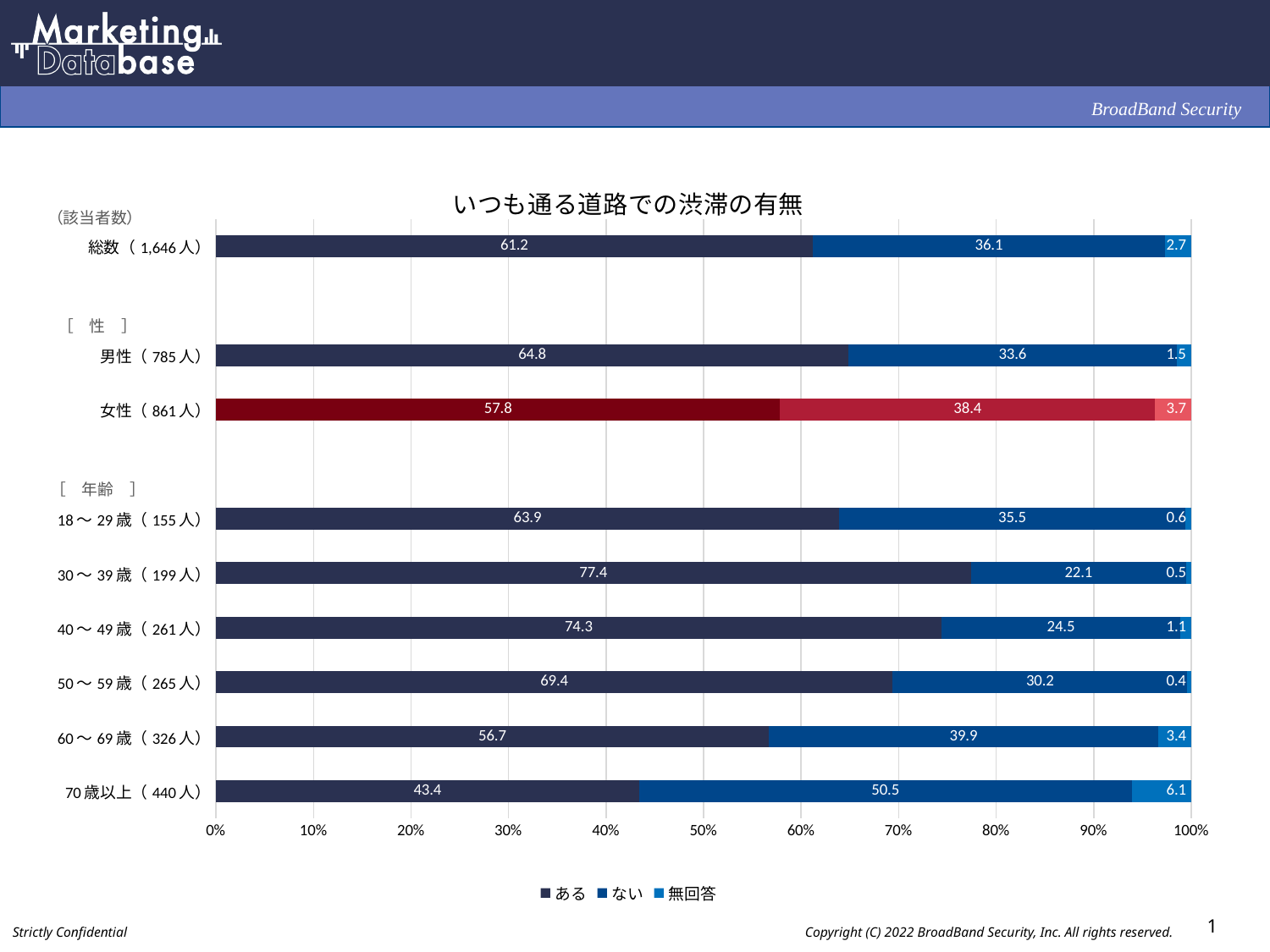
What is the value of ない for 70歳以上 (440人)? 50.5 Is the ある value for 40～49歳 (261人) greater or less than 70%? greater What is the difference between the ある values for 男性 (785人) and 女性 (861人)? 7.0 Which is larger, the ない value for 60～69歳 (326人) or for 50～59歳 (265人)? 60～69歳 (326人) Which category has the highest value for 無回答? 70歳以上 (440人) What kind of chart is shown on the slide? Stacked bar chart Which category has the lowest value for ある? 70歳以上 (440人) What is the value of ある for 総数 (1,646人)? 61.2 Which category has the highest value for ある? 30～39歳 (199人) How many series does the legend list? 3 How many categories are plotted in the chart? 9 What is the value of 無回答 for 女性 (861人)? 3.7